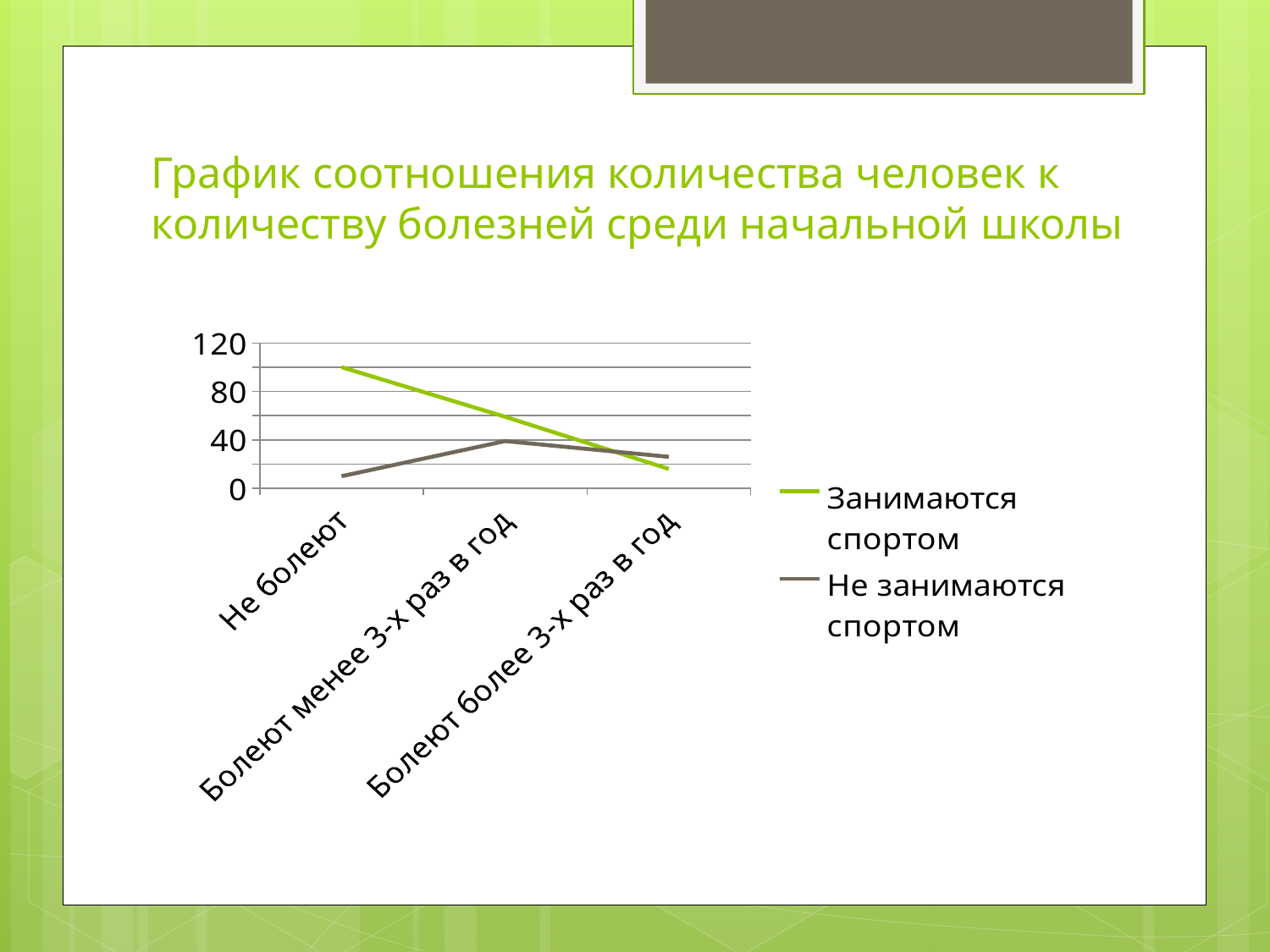
What kind of chart is shown on the slide? line chart Is the value for "Занимаются спортом" at "Не болеют" greater or less than 80? greater Is the value for "Не занимаются спортом" at "Не болеют" greater or less than 40? less Which category has the lowest value for the series "Не занимаются спортом"? Не болеют How many categories are shown on the x axis? 3 Which category has the highest value for the series "Занимаются спортом"? Не болеют How many series does the legend list? 2 At "Не болеют", which series has the larger value: "Занимаются спортом" or "Не занимаются спортом"? Занимаются спортом Do the values for the series "Занимаются спортом" rise or fall from left to right along the x axis? fall Is the value for "Занимаются спортом" at "Болеют более 3-х раз в год" greater or less than 40? less Which category has the highest value for the series "Не занимаются спортом"? Болеют менее 3-х раз в год Which category has the lowest value for the series "Занимаются спортом"? Болеют более 3-х раз в год